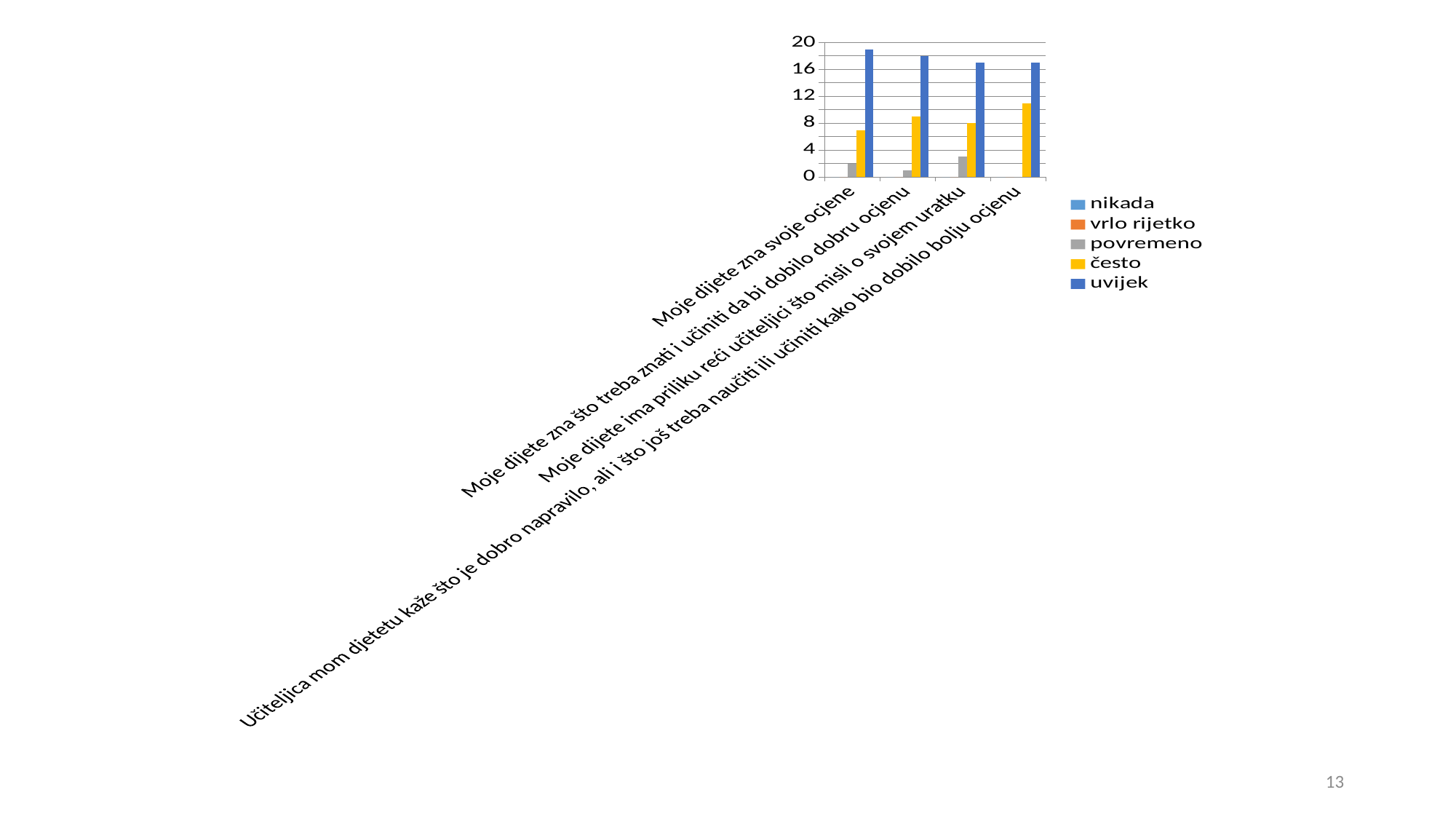
Which series is represented by the yellow bars? često Is the value of 'uvijek' for 'Moje dijete zna svoje ocjene' greater or less than 16? greater Which series is represented by the dark blue bars? uvijek Is the value of 'često' for 'Moje dijete zna što treba znati i učiniti da bi dobilo dobru ocjenu' greater or less than 12? less Is the value of 'često' for 'Učiteljica mom djetetu kaže što je dobro napravilo, ali i što još treba naučiti ili učiniti kako bio dobilo bolju ocjenu' greater or less than 8? greater How many series does the legend list? 5 For 'Moje dijete zna svoje ocjene', which is larger: the value for 'često' or the value for 'uvijek'? uvijek How many categories are shown on the x axis? 4 For 'Moje dijete zna svoje ocjene', which series has the highest value? uvijek Which is larger: the 'često' value for 'Moje dijete zna svoje ocjene' or the 'često' value for 'Učiteljica mom djetetu kaže što je dobro napravilo, ali i što još treba naučiti ili učiniti kako bio dobilo bolju ocjenu'? Učiteljica mom djetetu kaže što je dobro napravilo, ali i što još treba naučiti ili učiniti kako bio dobilo bolju ocjenu What kind of chart is shown on the slide? bar chart